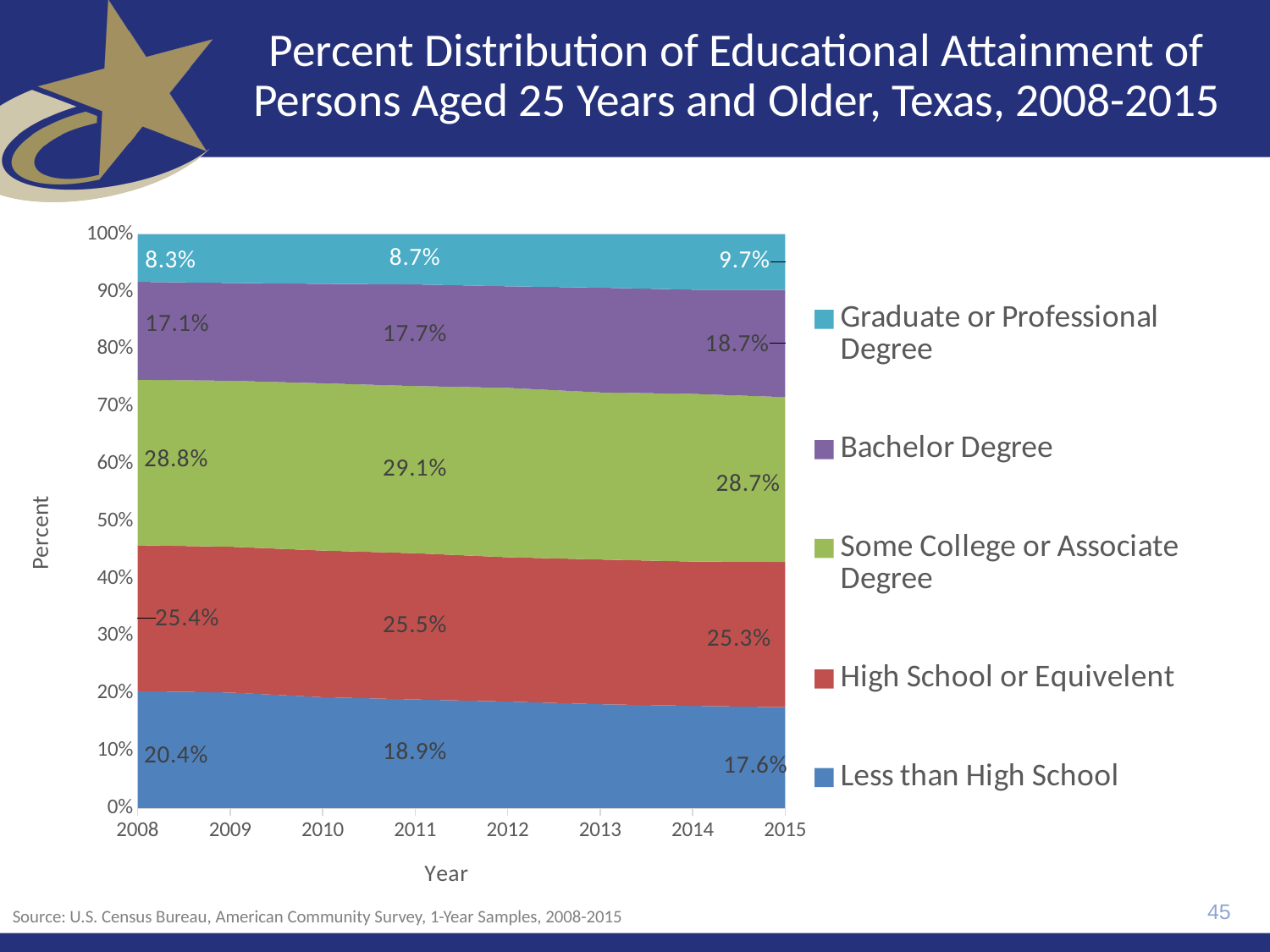
By how many percentage points did the Less than High School share change from 2008 to 2015? 2.8 percentage points What is the value for Bachelor Degree in 2015? 18.7% What is the value for Less than High School in 2008? 20.4% Which educational attainment category has the lowest share in 2008? Graduate or Professional Degree What is the value for Graduate or Professional Degree in 2015? 9.7% What is the value for Some College or Associate Degree in 2011? 29.1% What type of chart is shown on the slide? Stacked area chart Which educational attainment category has the highest share in 2015? Some College or Associate Degree In 2015, which is larger: the Bachelor Degree share or the Less than High School share? Bachelor Degree How many series does the legend list? 5 Does the share of Less than High School rise or fall from 2008 to 2015? Fall How many years are shown along the x axis? 8